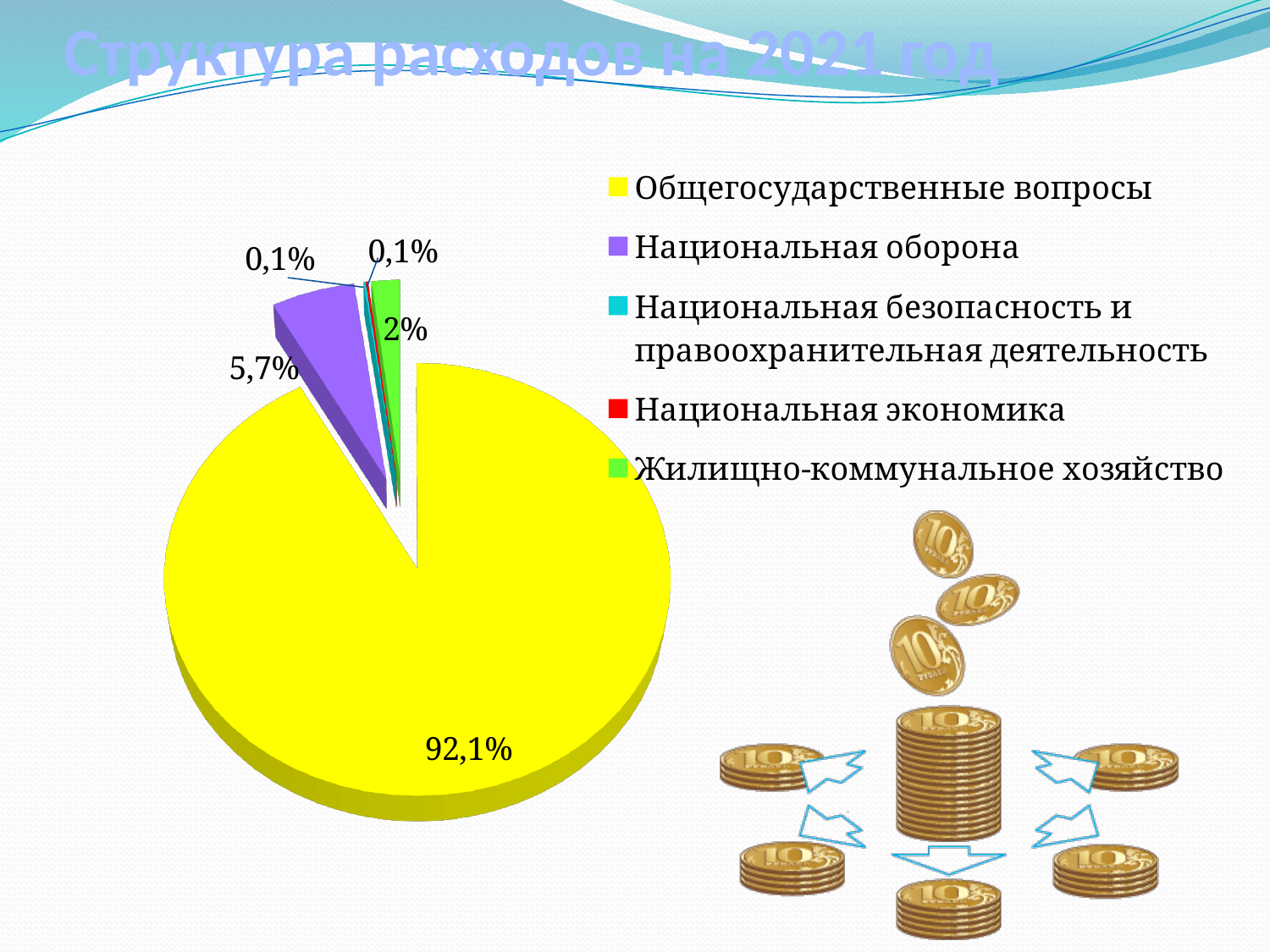
What share of the pie does Национальная оборона have? 5,7% What is the title of the chart on the slide? Структура расходов на 2021 год What is the smallest share shown on the pie chart? 0,1% How many categories does the legend of the pie chart list? 5 What share of the pie does Общегосударственные вопросы have? 92,1% How many slices does the pie chart have? 5 What share of the pie does Национальная экономика have? 0,1% Which has a larger share, Национальная оборона or Жилищно-коммунальное хозяйство? Национальная оборона Which category has the largest share of the pie? Общегосударственные вопросы What is the difference between the shares of Общегосударственные вопросы and Национальная оборона? 86,4% What kind of chart is shown on the slide? pie chart